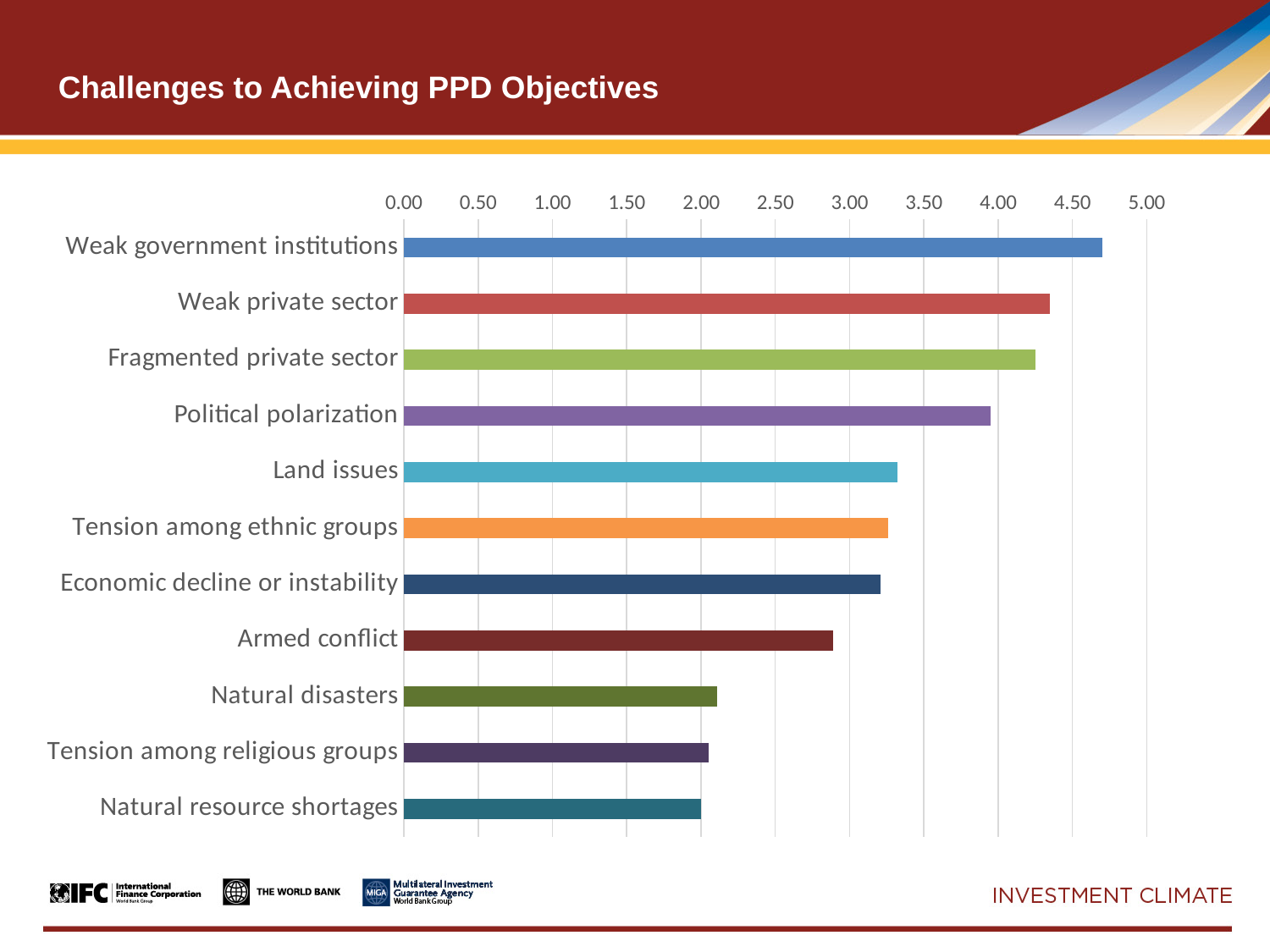
Is the value for Armed conflict greater or less than 3.00? less Is the value for Fragmented private sector greater or less than 4.00? greater How many challenge categories are plotted in the chart? 11 Which challenge has the highest value in the chart? Weak government institutions What is the title of the slide containing the chart? Challenges to Achieving PPD Objectives What kind of chart is shown on the slide? bar chart Which has the larger value, Weak private sector or Land issues? Weak private sector Is the value for Land issues greater or less than 3.00? greater Which has the larger value, Armed conflict or Natural disasters? Armed conflict